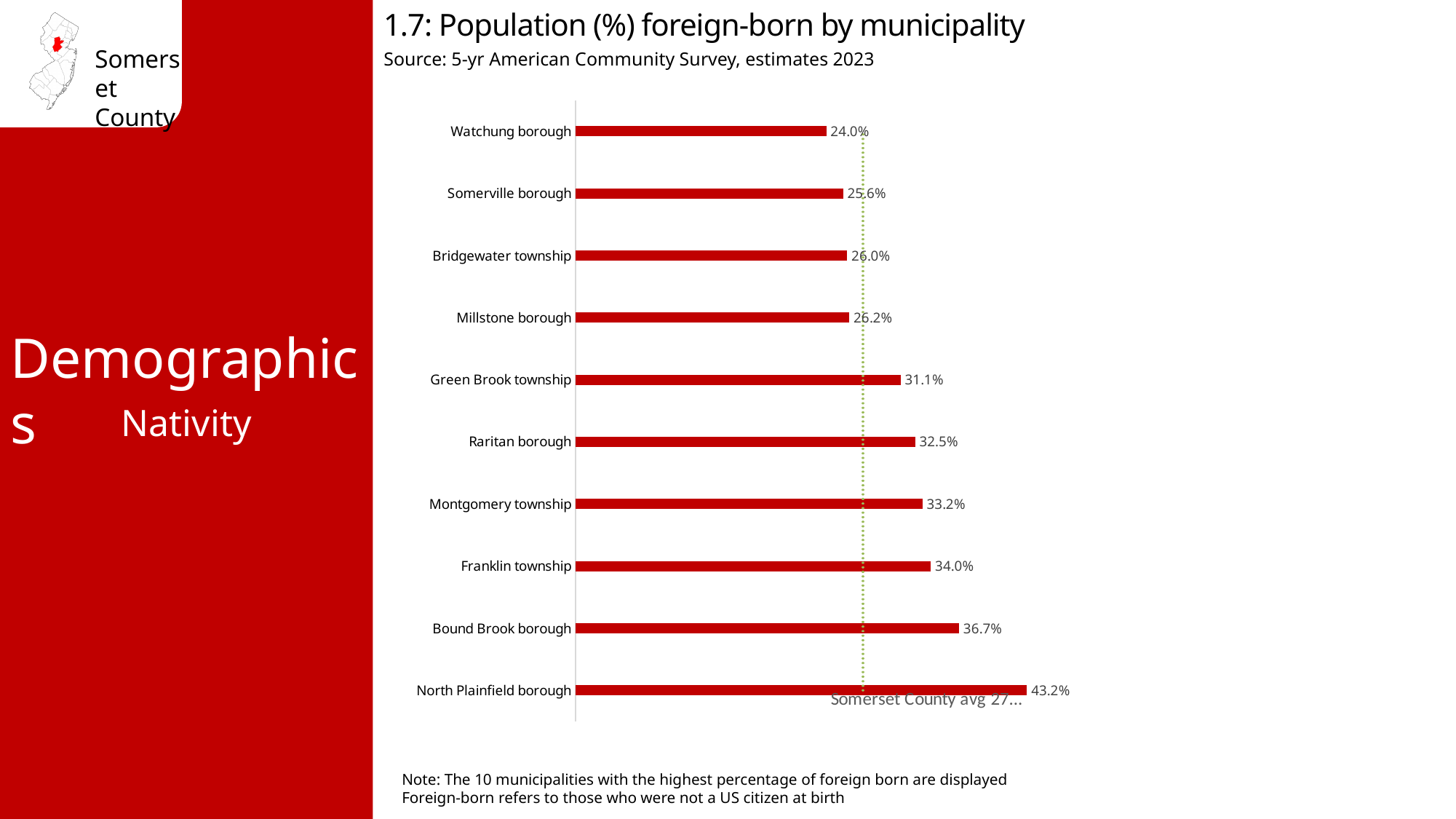
Which municipality has the lowest percentage of foreign-born population? Watchung borough What is the difference in foreign-born percentage between North Plainfield borough and Bound Brook borough? 6.5% What is the difference in foreign-born percentage between Green Brook township and Watchung borough? 7.1% Which municipality has the highest percentage of foreign-born population? North Plainfield borough What is the percentage of foreign-born population for North Plainfield borough? 43.2% How many municipalities are shown in the chart? 10 What is the title of the chart? 1.7: Population (%) foreign-born by municipality What is the percentage of foreign-born population for Franklin township? 34.0% What is the percentage of foreign-born population for Watchung borough? 24.0% Which has a higher foreign-born percentage, Montgomery township or Millstone borough? Montgomery township What is the percentage of foreign-born population for Raritan borough? 32.5% What type of chart is used to show the foreign-born population by municipality? Bar chart